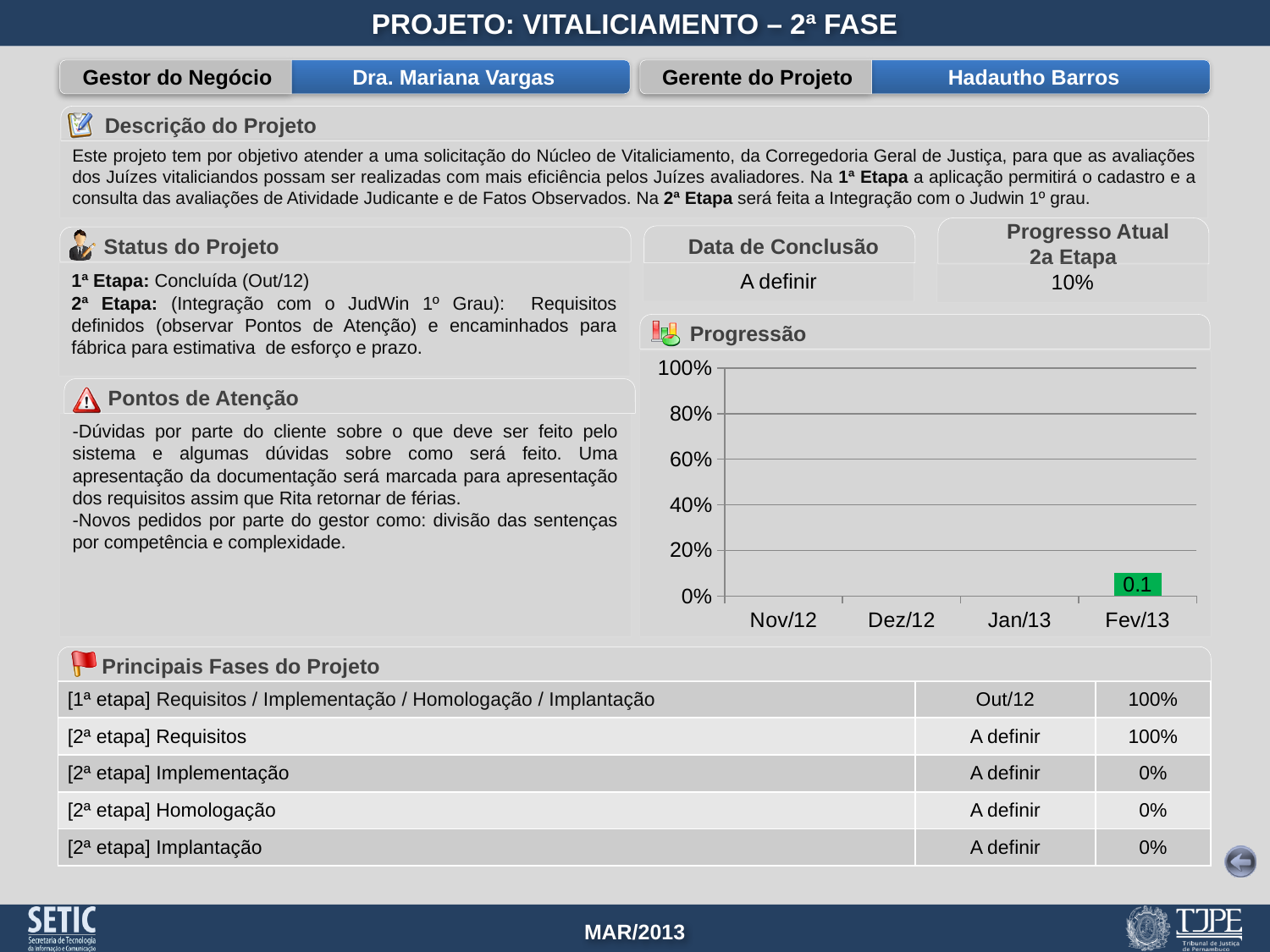
Is the value for Fev/13 in the Progressão chart greater or less than 20%? less What is the data label shown on the bar for Fev/13 in the Progressão chart? 0.1 What kind of chart is shown under the heading "Progressão"? bar chart How many categories are shown on the x axis of the Progressão chart? 4 Which category in the Progressão chart has the highest value? Fev/13 What is the highest value shown on the y axis of the Progressão chart? 100% What is the first category on the x axis of the Progressão chart? Nov/12 Is the value for Fev/13 in the Progressão chart greater or less than 40%? less